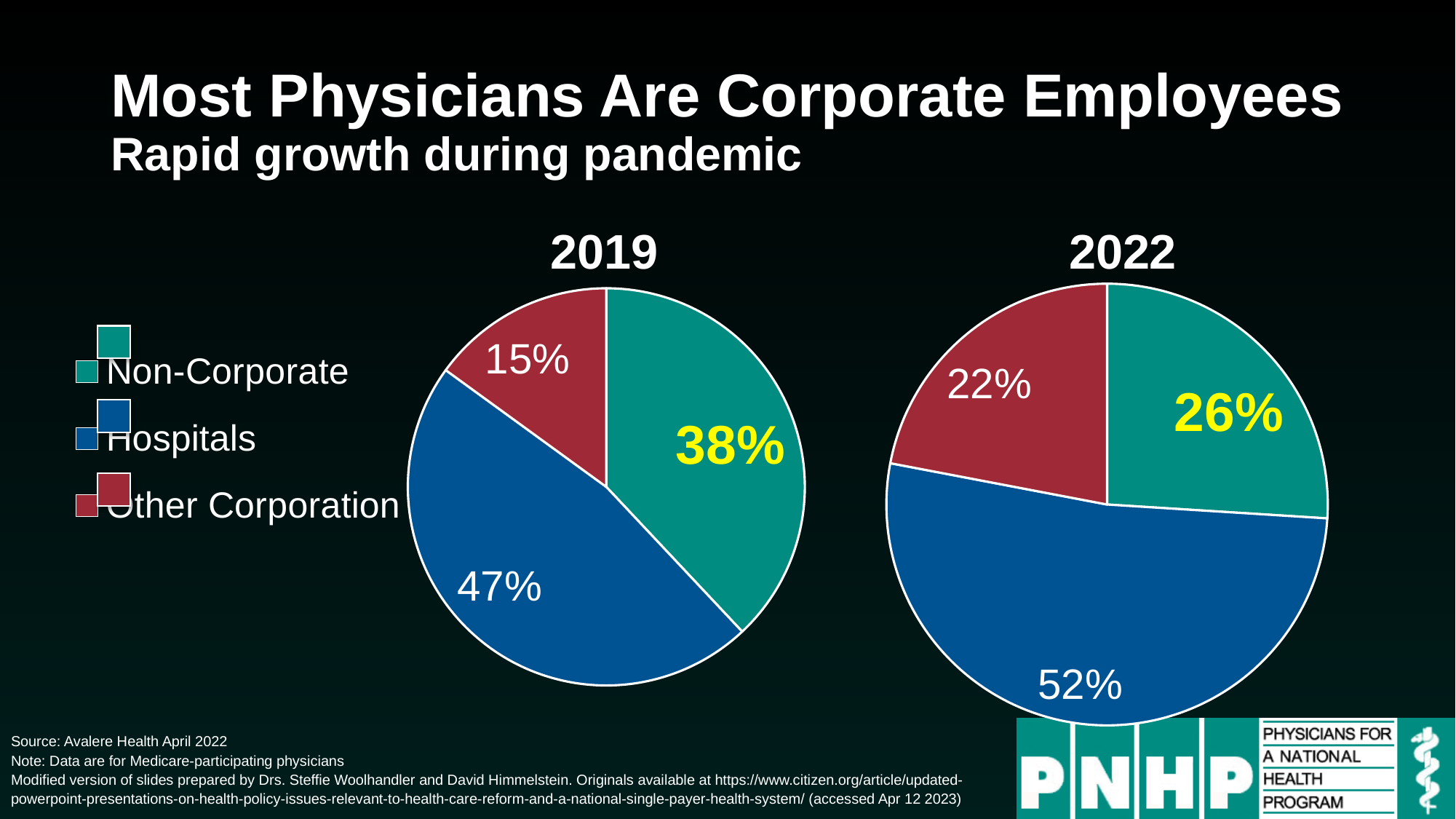
Which colour represents Hospitals in the pie charts? Blue In the 2022 pie chart, what share is Non-Corporate? 26% How many categories does each pie chart show? 3 In the 2019 pie chart, what share of physicians is Non-Corporate? 38% In the 2019 pie chart, what share is Other Corporation? 15% In the 2022 pie chart, which category has the smallest share? Other Corporation What is the difference between the Hospitals share in 2022 and in 2019? 5% In the 2022 pie chart, what share of physicians is Hospitals? 52% What kind of charts are shown on the slide? Pie charts In the 2019 pie chart, what is the difference between the Hospitals share and the Non-Corporate share? 9% Which is larger: the Other Corporation share in 2019 or in 2022? 2022 In the 2019 pie chart, which category has the largest share? Hospitals